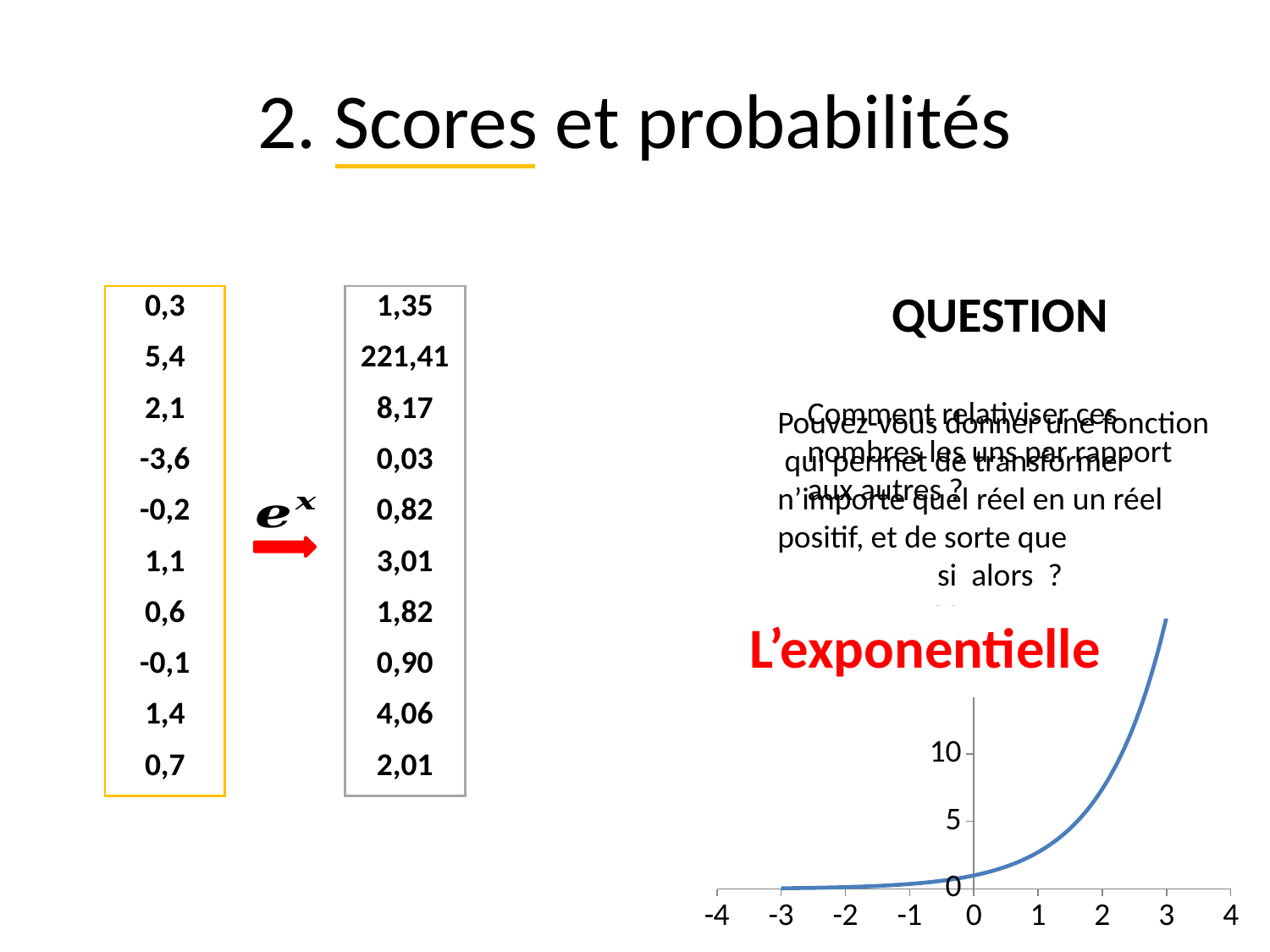
What colour is the curve plotted on the chart? blue What kind of chart is shown at the bottom right of the slide? line chart How many tick labels are shown on the x axis of the chart? 9 Is the value of the curve at x = 3 greater or less than 10? greater Which is larger on the chart: the value at x = 2 or the value at x = -2? x = 2 Is the value of the curve at x = 2 greater or less than 5? greater At which x value shown on the chart does the curve reach its lowest point? -3 Is the value of the curve at x = -2 greater or less than 5? less At which x value shown on the chart does the curve reach its highest point? 3 What is the highest tick label shown on the y axis of the chart? 10 Do the values on the chart rise or fall as x increases from -3 to 3? rise